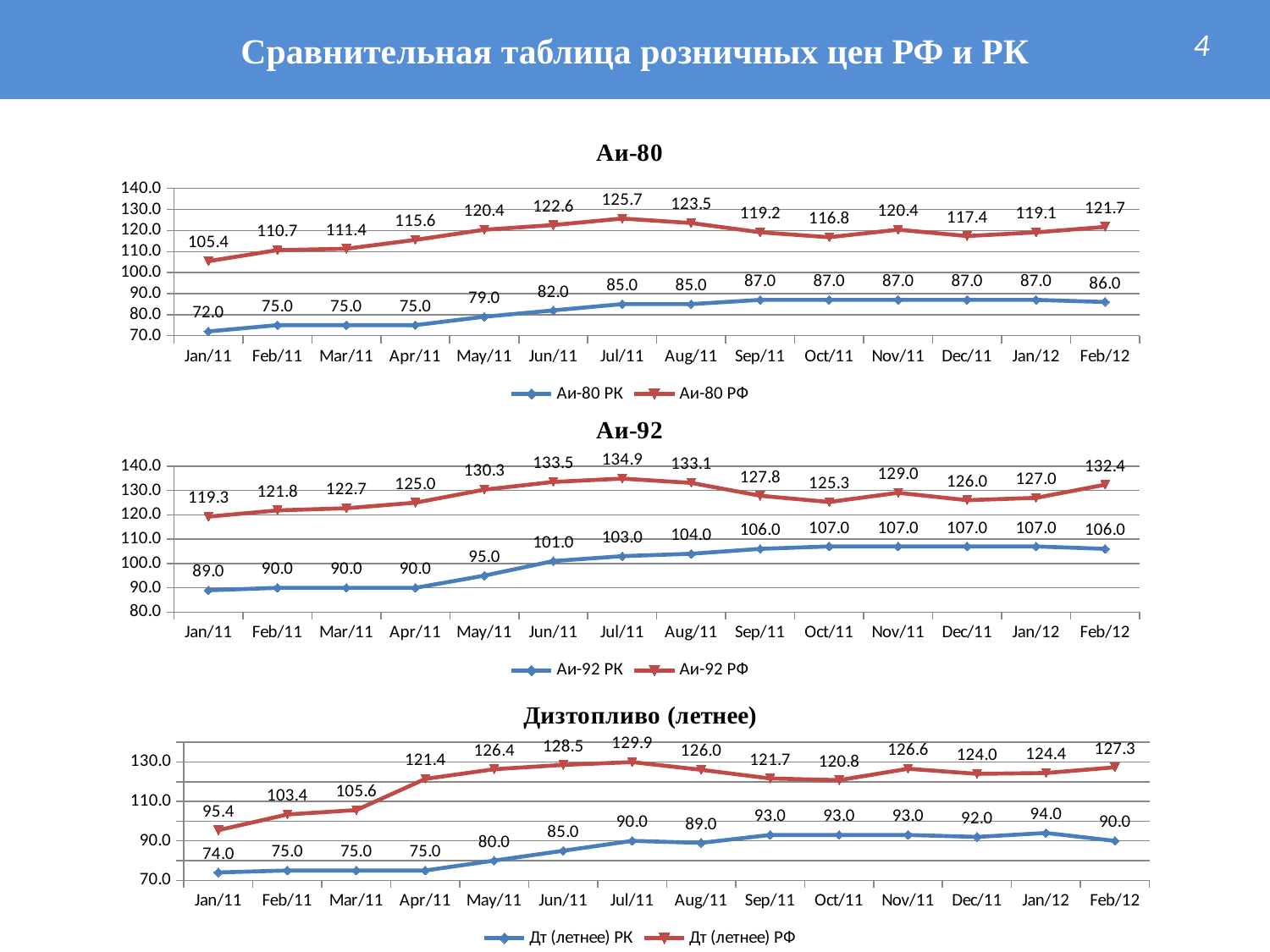
In the Дизтопливо (летнее) chart, what is the value of Дт (летнее) РФ in Apr/11? 121.4 In the Дизтопливо (летнее) chart, which is larger in Jan/12: Дт (летнее) РК or Дт (летнее) РФ? Дт (летнее) РФ In the Аи-92 chart, what is the value of Аи-92 РФ in Jan/11? 119.3 In the Аи-80 chart, what is the value of Аи-80 РК in Jan/11? 72.0 In the Аи-80 chart, what is the difference between Аи-80 РФ and Аи-80 РК in Feb/12? 35.7 What type of chart is the Аи-80 chart? Line chart In the Аи-92 chart, in which month is Аи-92 РК lowest? Jan/11 In the Аи-80 chart, in which month is Аи-80 РФ highest? Jul/11 In the Аи-92 chart, how many series does the legend list? 2 In the Аи-92 chart, what is the difference between Аи-92 РФ in Jul/11 and Jan/11? 15.6 In the Дизтопливо (летнее) chart, how many months are shown on the x axis? 14 In the Аи-80 chart, what is the value of Аи-80 РФ in Jul/11? 125.7